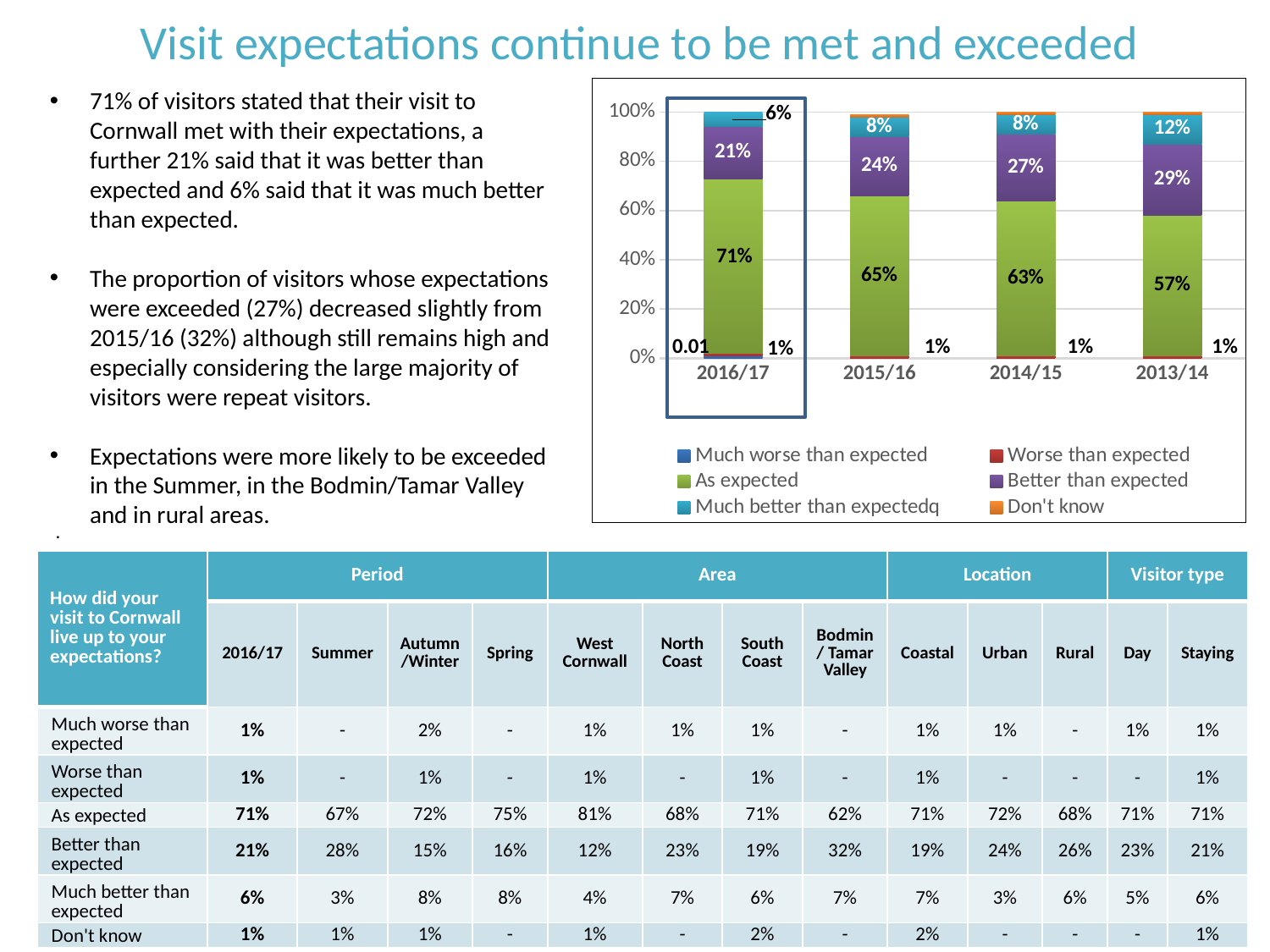
Which year has the highest 'As expected' value in the chart? 2016/17 What is the 'Much better than expected' value for 2015/16 in the chart? 8% What is the 'As expected' value for 2016/17 in the chart? 71% What is the difference between the 'Better than expected' values for 2014/15 and 2016/17? 6% Which year's bar is outlined with a box in the chart? 2016/17 Which year has the lowest 'As expected' value in the chart? 2013/14 How many year categories are shown on the x axis of the chart? 4 Is the 'Much better than expected' value larger for 2013/14 or for 2014/15? 2013/14 What is the 'Better than expected' value for 2013/14 in the chart? 29% What type of chart is shown on the slide? stacked bar chart Does the 'As expected' value rise or fall moving from 2016/17 to 2013/14 along the x axis? fall How many series does the chart legend list? 6